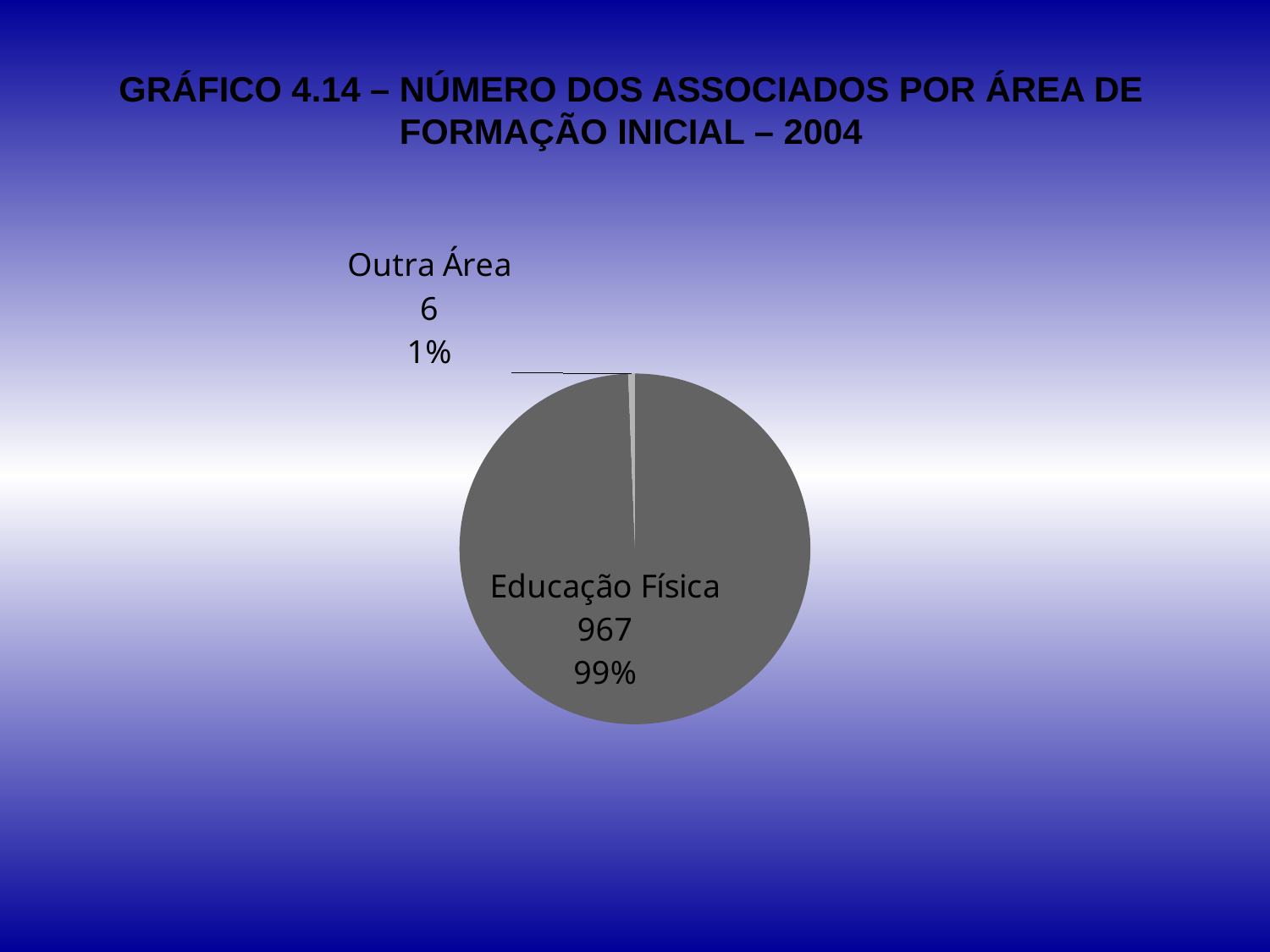
What is the value for Educação Física? 967 What is the difference between the values for Educação Física and Outra Área? 961 What is the value for Outra Área? 6 What is the total of the two values shown in the pie chart? 973 What year is referenced in the chart title? 2004 How many slices does the pie chart have? 2 Which category has the smallest slice? Outra Área Which is larger, the value for Educação Física or the value for Outra Área? Educação Física Which category has the largest slice? Educação Física What share of the pie does Outra Área represent? 1% What share of the pie does Educação Física represent? 99% What kind of chart is shown on the slide? pie chart